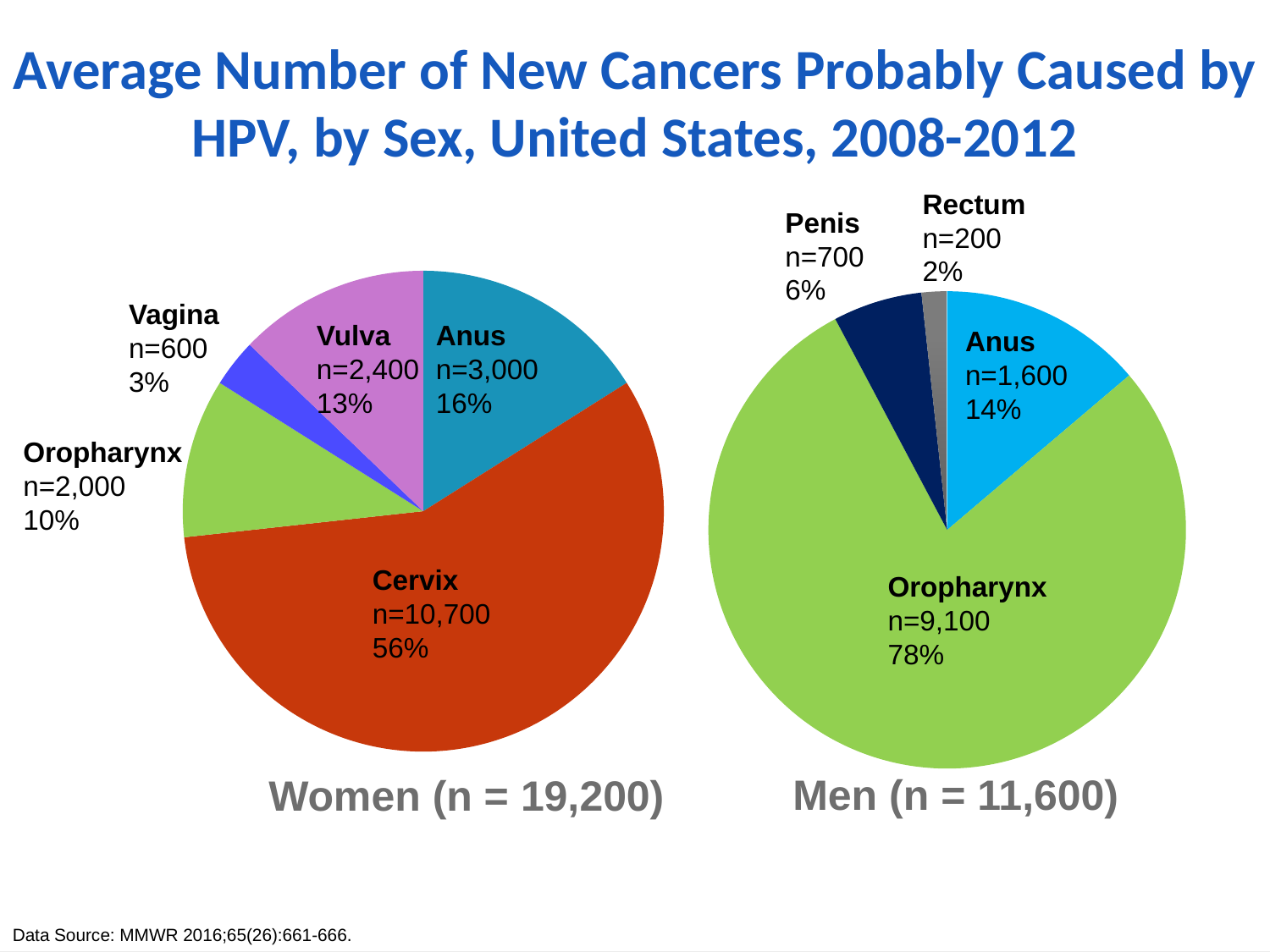
Which is larger: the number of Anus cancers in the Women chart or in the Men chart? Women In the Men pie chart, what share of cancers is Oropharynx? 78% How many slices does the Women pie chart have? 5 What type of chart is used on this slide? Pie chart What is the difference in the number of Oropharynx cancers between the Men chart and the Women chart? 7,100 In the Men pie chart, which cancer site has the smallest slice? Rectum In the Women pie chart, what percentage of cancers is Vagina? 3% How many slices does the Men pie chart have? 4 What is the total number of cancers shown for the Men pie chart? 11,600 In the Women pie chart, how many new cancers are attributed to Cervix? n=10,700 In the Women pie chart, which cancer site has the largest slice? Cervix In the Men pie chart, how many new cancers are attributed to Penis? n=700